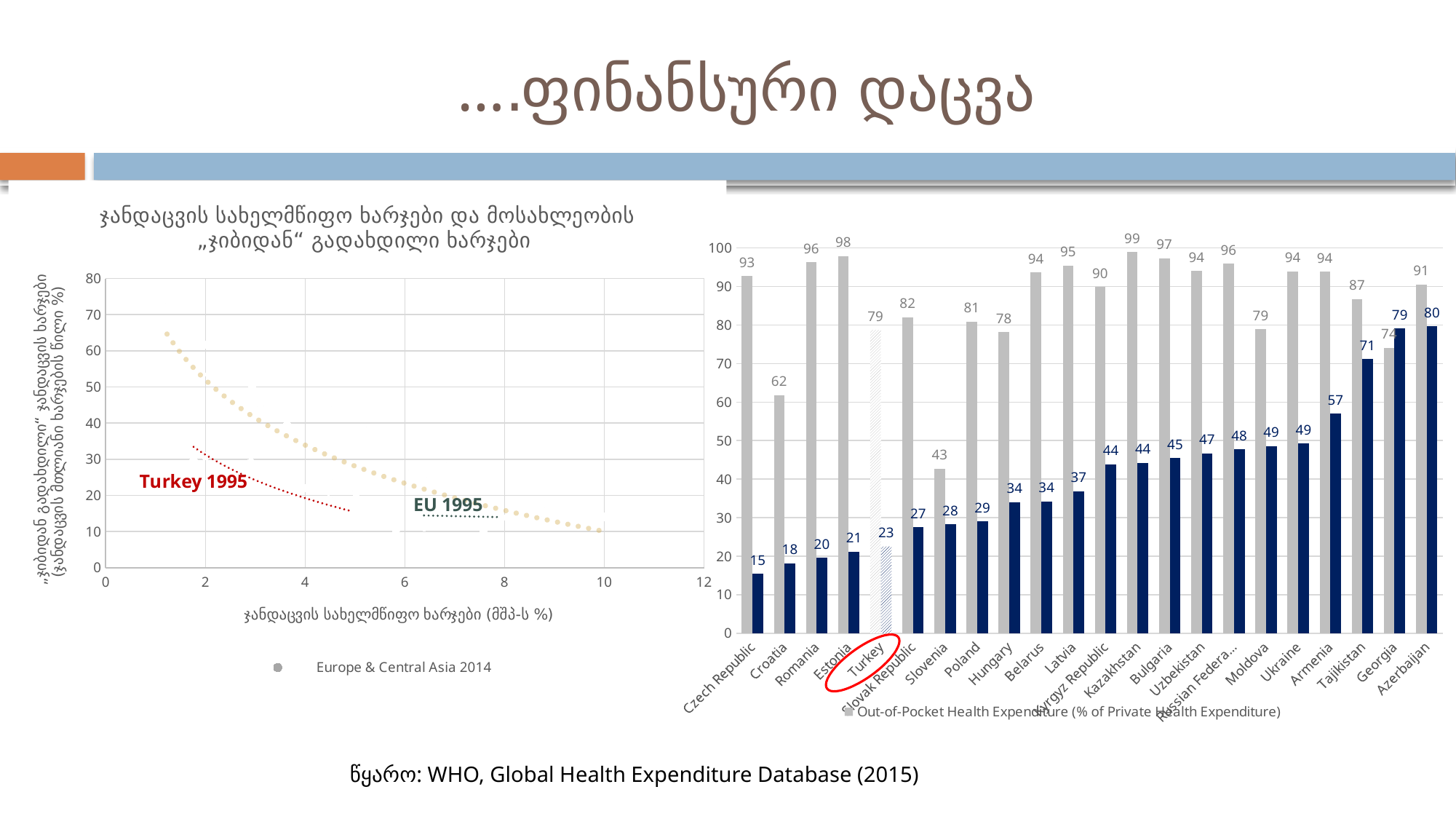
What kind of chart is the chart on the left of the slide? scatter chart On the right-hand bar chart, how many countries are shown on the x axis? 22 What kind of chart is the chart on the right of the slide? bar chart On the right-hand bar chart, what is the difference between the grey bar and the dark blue bar for Croatia? 44 On the right-hand bar chart, which country has the lowest dark blue bar value? Czech Republic On the right-hand bar chart, which country has the lowest grey bar value? Slovenia On the right-hand bar chart, do the dark blue bar values rise or fall from left to right? rise On the left-hand scatter chart, what is the legend entry for the dotted series? Europe & Central Asia 2014 On the right-hand bar chart, what is the grey bar value for Turkey? 79 On the right-hand bar chart, which is larger: the dark blue bar for Armenia or the dark blue bar for Tajikistan? Tajikistan On the right-hand bar chart, what is the dark blue bar value for Georgia? 79 On the right-hand bar chart, which country has the highest grey bar value? Kazakhstan